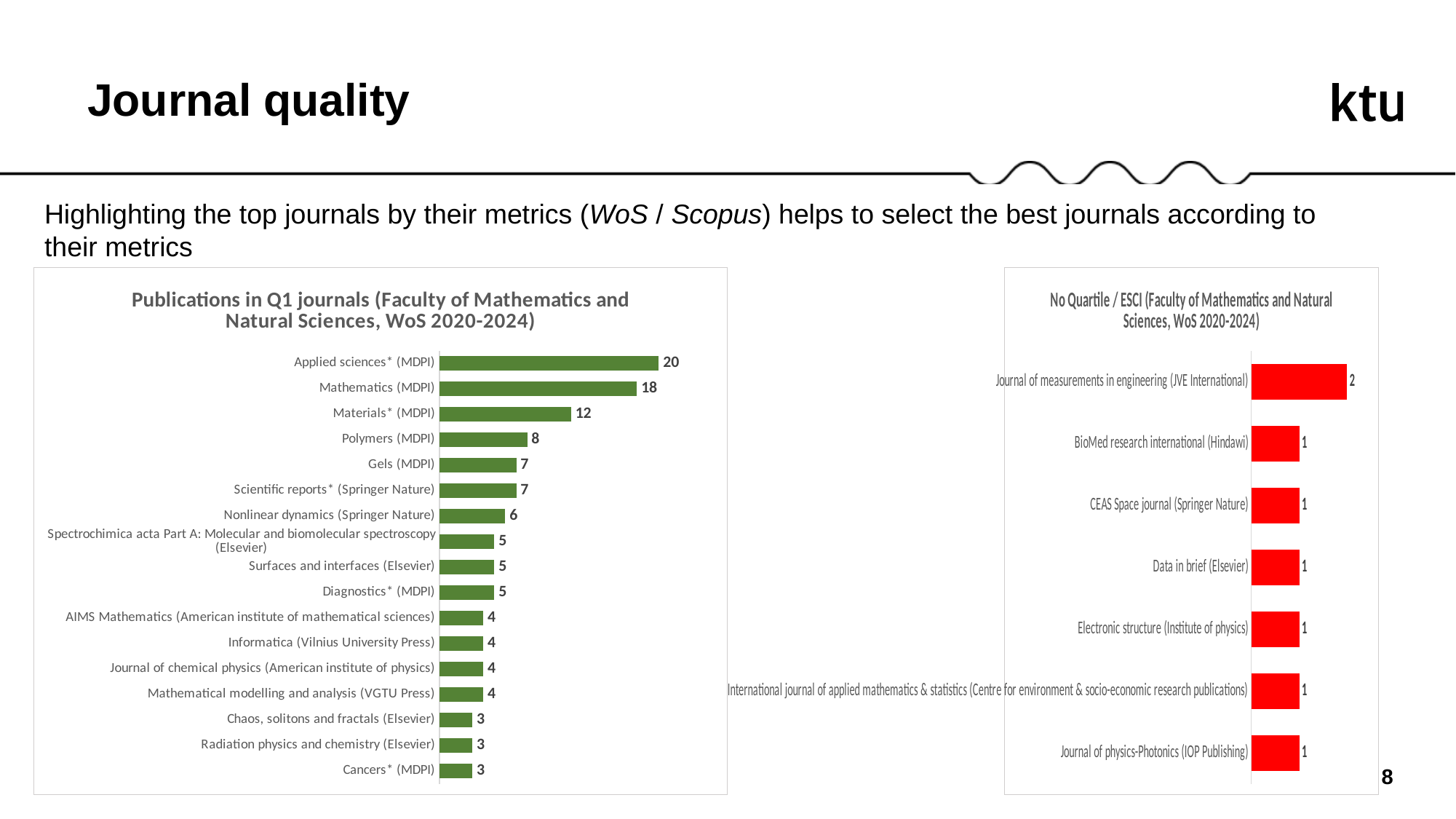
In the 'No Quartile / ESCI' chart, what is the value for Journal of measurements in engineering (JVE International)? 2 How many journals are listed in the 'No Quartile / ESCI' chart? 7 In the 'Publications in Q1 journals' chart, what is the difference between Applied sciences* (MDPI) and Materials* (MDPI)? 8 In the 'Publications in Q1 journals' chart, which journal has the highest number of publications? Applied sciences* (MDPI) In the 'Publications in Q1 journals' chart, what is the value for Polymers (MDPI)? 8 In the 'Publications in Q1 journals' chart, how many publications are shown for Mathematics (MDPI)? 18 How many journals are listed in the 'Publications in Q1 journals' chart? 17 In the 'No Quartile / ESCI' chart, what is the value for Data in brief (Elsevier)? 1 In the 'No Quartile / ESCI' chart, which journal has the highest value? Journal of measurements in engineering (JVE International) What type of chart is the 'Publications in Q1 journals' chart? Bar chart In the 'Publications in Q1 journals' chart, which has more publications: Nonlinear dynamics (Springer Nature) or Surfaces and interfaces (Elsevier)? Nonlinear dynamics (Springer Nature) What colour are the bars in the 'No Quartile / ESCI' chart? Red